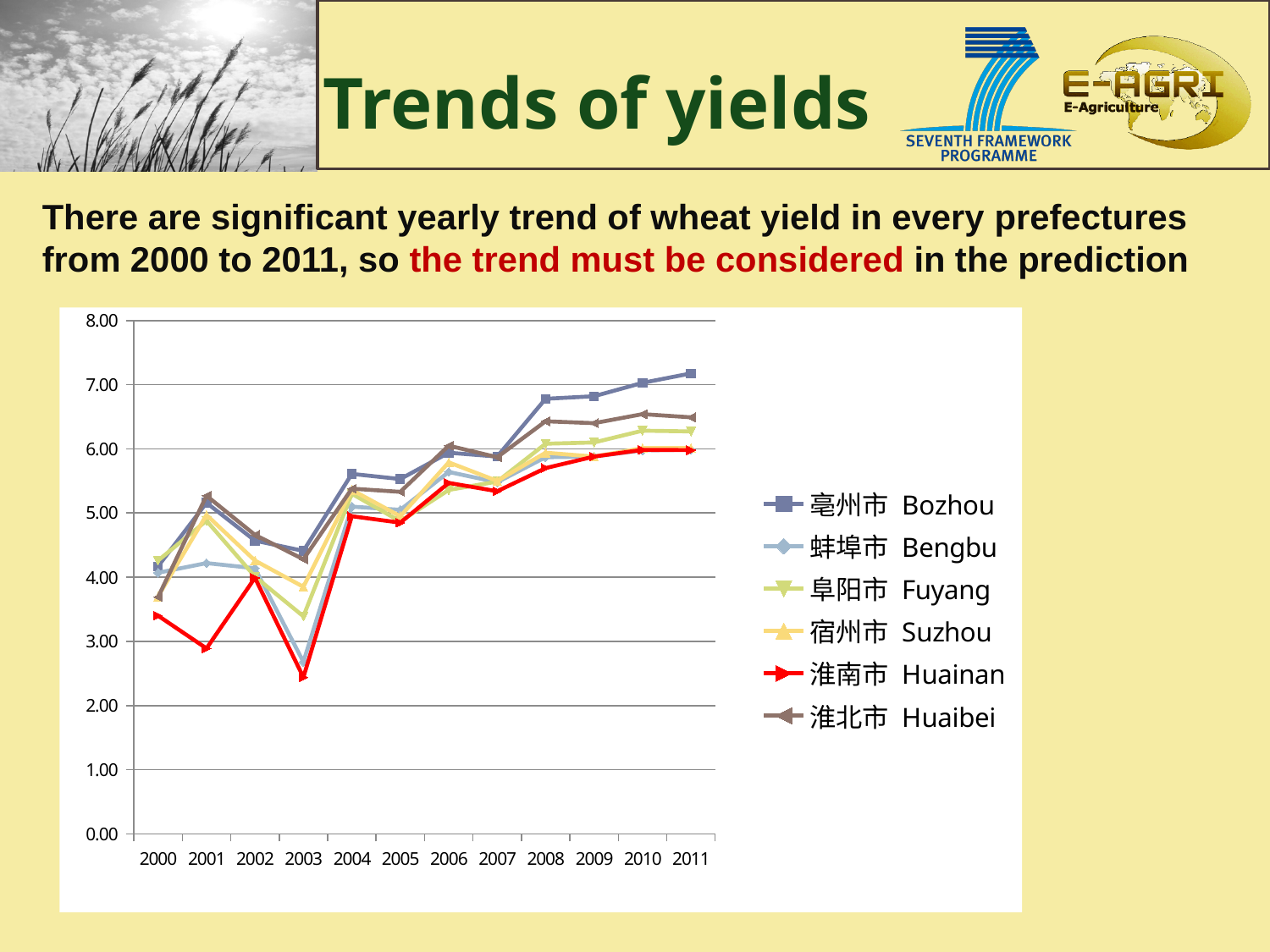
Do the yields for Bozhou rise or fall from 2004 to 2011? rise Is the value for Bozhou in 2011 greater or less than 7.00? greater Which prefecture has the lowest yield in 2000? Huainan Is the value for Huainan in 2003 greater or less than 3.00? less Which prefecture has the lowest yield in 2003? Huainan How many series does the legend list? 6 Is the value for Huaibei in 2011 greater or less than 6.00? greater Which prefecture is listed first in the legend? Bozhou Which prefecture has the highest yield in 2011? Bozhou What kind of chart is shown on the slide? line chart Which is larger in 2011, the value for Bozhou or the value for Huainan? Bozhou How many years are plotted along the x axis? 12